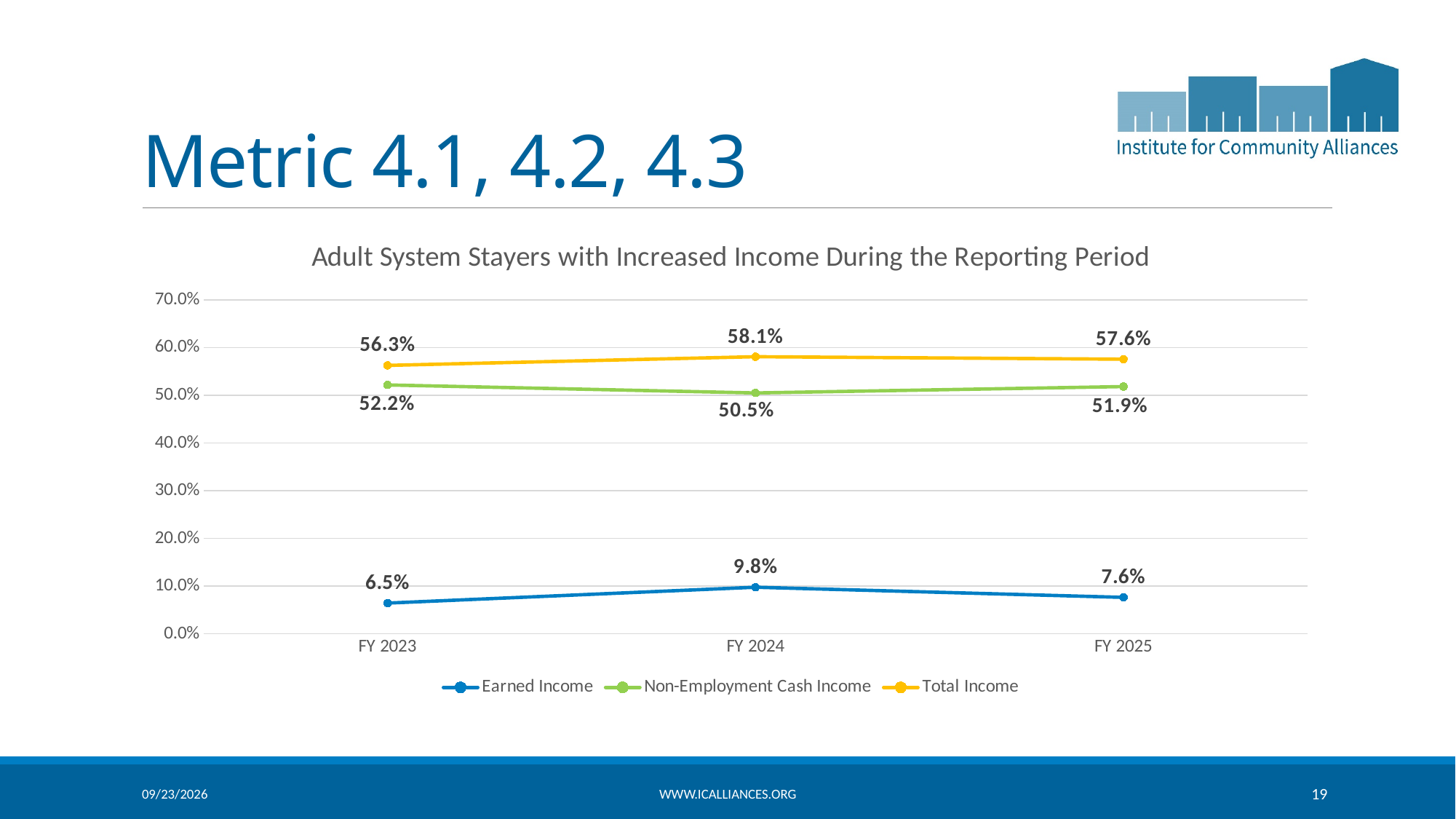
What is the Earned Income value for FY 2023? 6.5% What kind of chart is shown on the slide? line chart What is the title of the chart? Adult System Stayers with Increased Income During the Reporting Period In which fiscal year is Non-Employment Cash Income lowest? FY 2024 What is the Total Income value for FY 2024? 58.1% How many series does the legend list? 3 What is the difference between Total Income and Non-Employment Cash Income in FY 2024? 7.6% What is the Non-Employment Cash Income value for FY 2025? 51.9% How many fiscal years are shown on the x axis? 3 Which is larger in FY 2025: Total Income or Non-Employment Cash Income? Total Income Is the Earned Income value for FY 2024 greater or less than 20.0%? less In which fiscal year is Earned Income highest? FY 2024